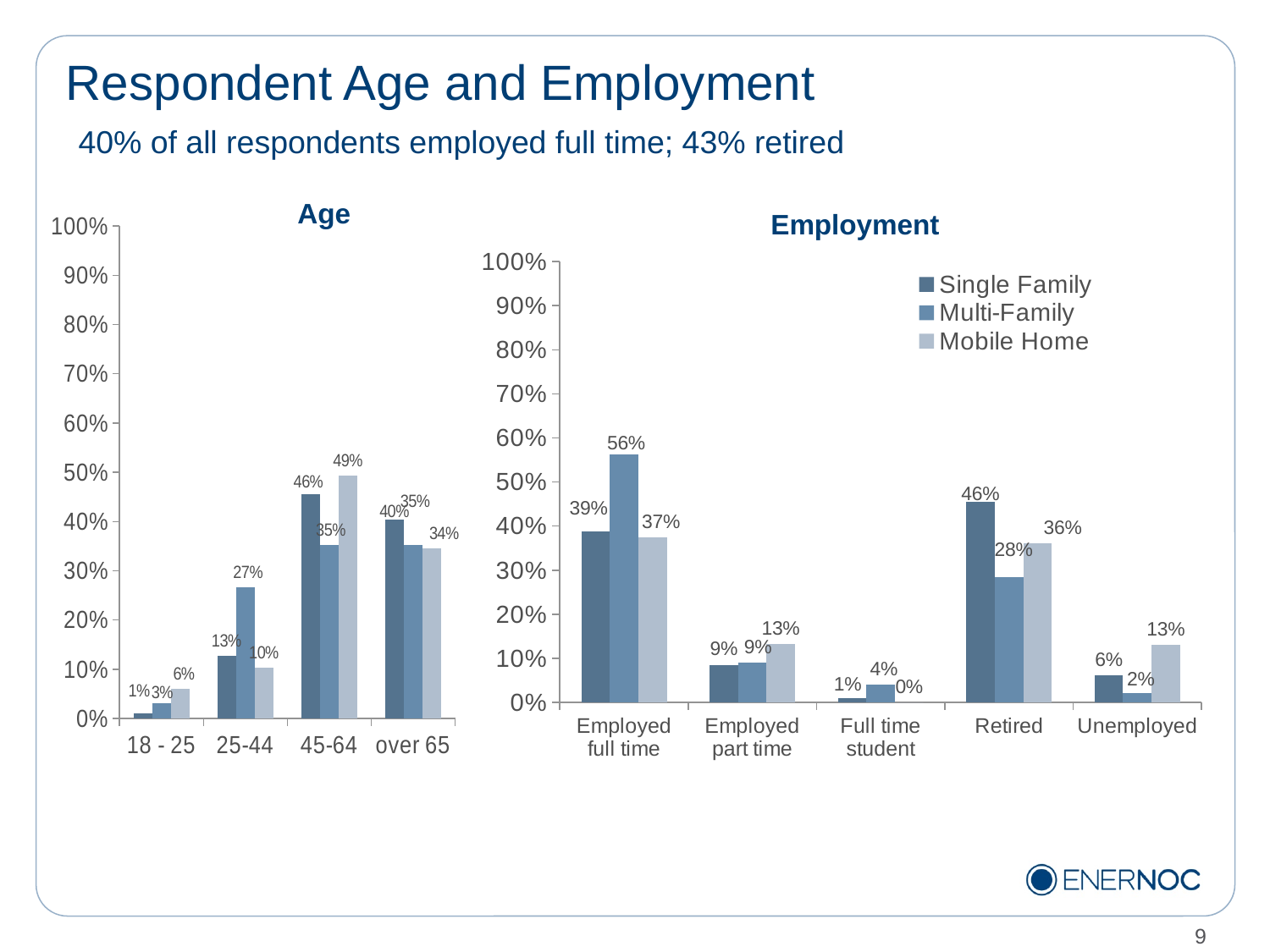
How many series does the legend of the Employment chart list? 3 In the Employment chart, what is the difference between the Single Family and Multi-Family values for Retired? 18% In the Age chart, what is the highest value shown for the 45-64 group? 49% In the Employment chart, what is the value for Single Family respondents who are retired? 46% In the Employment chart, which is larger for Employed full time: Single Family or Mobile Home? Single Family How many age groups are shown on the x axis of the Age chart? 4 In the Employment chart, which employment category has the highest value for Multi-Family? Employed full time In the Employment chart, what is the value for Multi-Family respondents who are employed full time? 56% How many employment categories are shown on the x axis of the Employment chart? 5 What type of chart is the Age chart? Bar chart In the Employment chart, what is the value for Mobile Home respondents who are unemployed? 13% In the Employment chart, which employment category has the lowest value for Mobile Home? Full time student